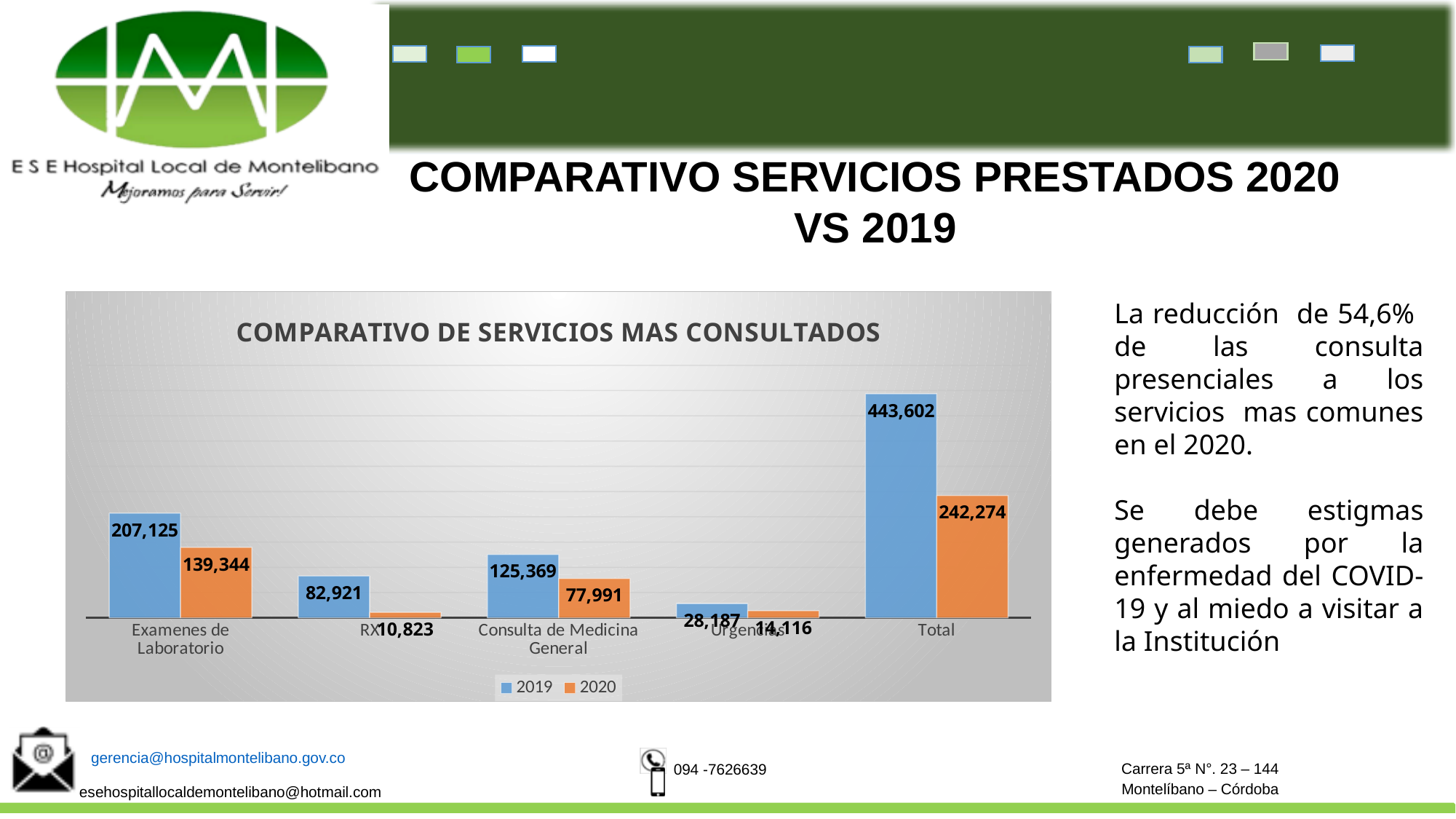
How many categories are shown on the x axis of the chart? 5 What is the 2020 value for RX? 10,823 Excluding Total, which category has the highest 2019 value? Examenes de Laboratorio What is the 2019 value for Urgencias? 28,187 What is the 2019 value for Examenes de Laboratorio? 207,125 What is the title of the chart? COMPARATIVO DE SERVICIOS MAS CONSULTADOS Which category has the lowest 2020 value? RX What is the difference between the 2019 and 2020 values for Total? 201,328 What type of chart is shown on the slide? Bar chart Which is larger for Consulta de Medicina General, the 2019 value or the 2020 value? 2019 How many series does the chart legend list? 2 What is the 2020 value for Consulta de Medicina General? 77,991